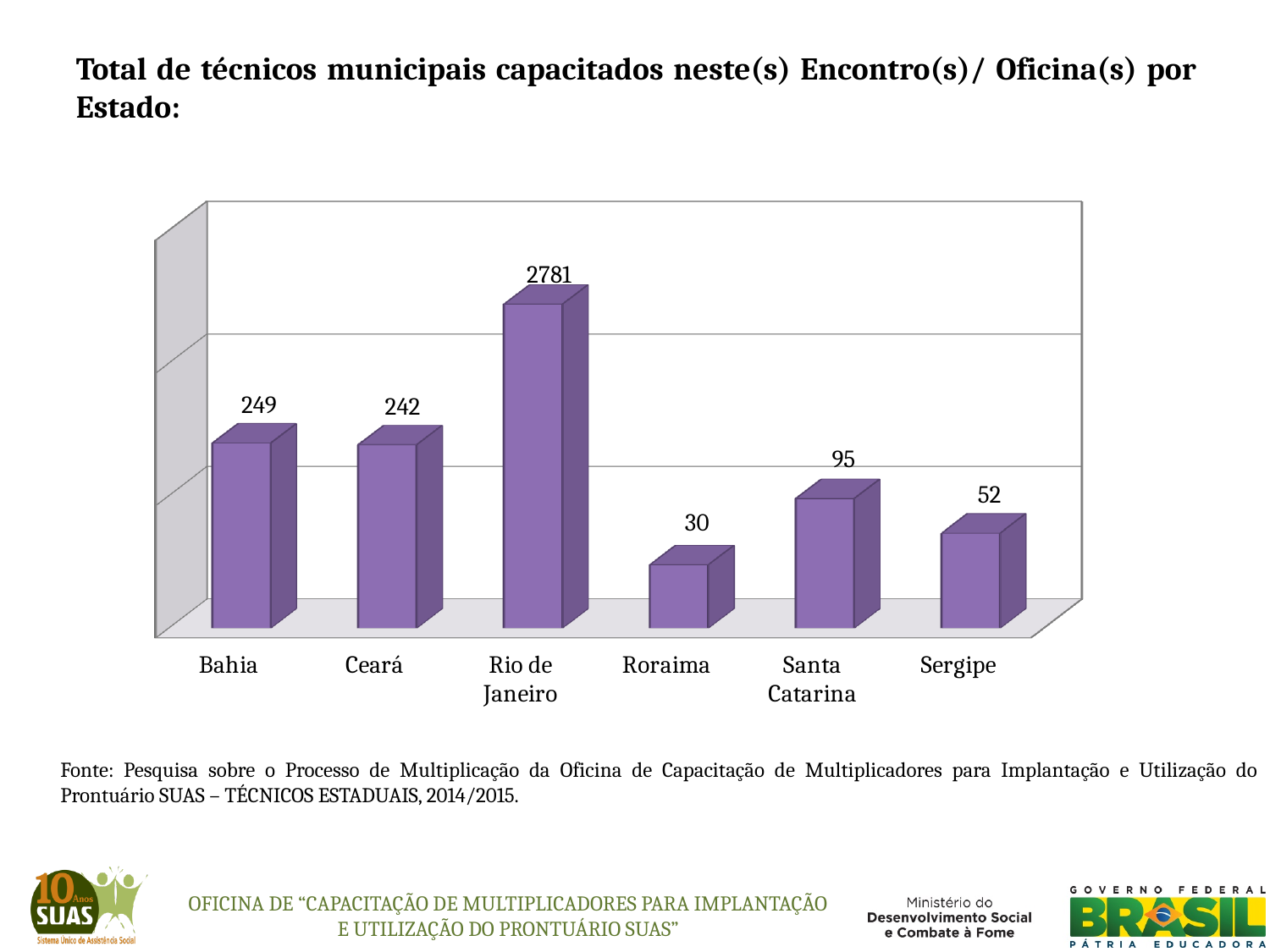
What is the value for Bahia? 249 Which is larger, the value for Sergipe or the value for Roraima? Sergipe Which state has the lowest value? Roraima What is the difference between the values for Bahia and Ceará? 7 What is the value for Santa Catarina? 95 What is the difference between the values for Santa Catarina and Sergipe? 43 Which state has the highest value? Rio de Janeiro What colour are the bars in the chart? purple How many states are shown on the chart? 6 What is the total of the values for Roraima and Sergipe? 82 What kind of chart is shown on the slide? bar chart What is the value for Rio de Janeiro? 2781